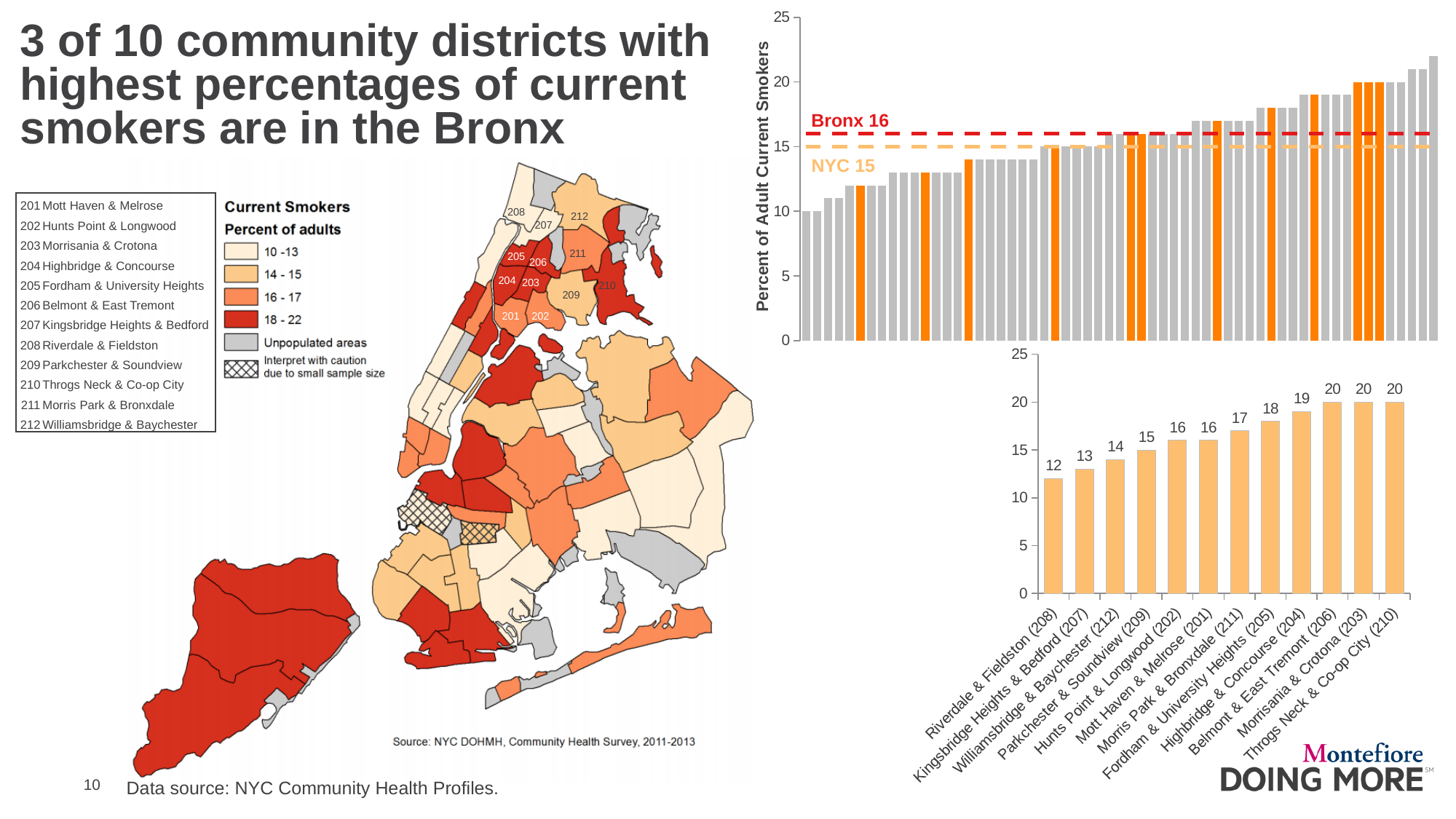
In the bottom-right bar chart, is the value for Belmont & East Tremont (206) greater or less than 15? greater In the top-right chart, what value is marked by the dashed line labelled NYC? 15 In the bottom-right bar chart, what is the value for Highbridge & Concourse (204)? 19 In the bottom-right bar chart, what is the difference between Throgs Neck & Co-op City (210) and Riverdale & Fieldston (208)? 8 In the bottom-right bar chart, what is the value for Morris Park & Bronxdale (211)? 17 What kind of chart is the bottom-right chart? bar chart In the top-right chart, what value is marked by the red dashed line labelled Bronx? 16 In the bottom-right bar chart, which is larger: Fordham & University Heights (205) or Parkchester & Soundview (209)? Fordham & University Heights (205) In the bottom-right bar chart, what is the value for Riverdale & Fieldston (208)? 12 In the bottom-right bar chart, do the values rise or fall from left to right? rise How many districts are shown in the bottom-right bar chart? 12 In the bottom-right bar chart, which district has the lowest value? Riverdale & Fieldston (208)